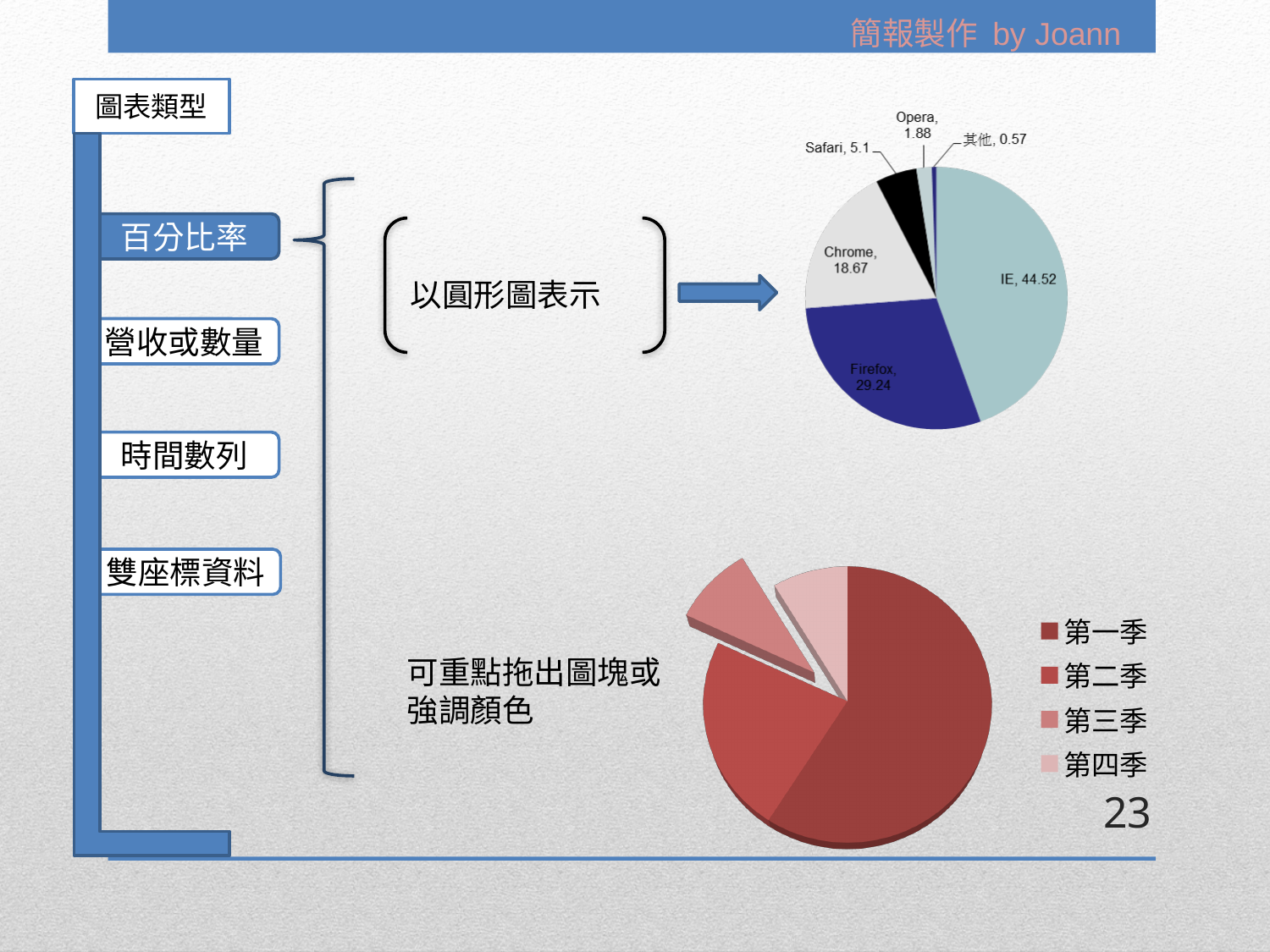
In the pie chart at the top right of the slide, what is the value for Safari? 5.1 In the pie chart at the top right of the slide, which is larger, the value for Chrome or the value for Safari? Chrome How many entries does the legend of the pie chart at the bottom of the slide list? 4 In the pie chart at the top right of the slide, what is the value for Chrome? 18.67 What kind of chart is shown at the bottom of the slide? Pie chart In the pie chart at the top right of the slide, which category has the smallest slice? 其他 In the pie chart at the top right of the slide, what is the value for IE? 44.52 In the pie chart at the top right of the slide, what is the difference between the values for IE and Firefox? 15.28 How many slices does the pie chart at the top right of the slide have? 6 In the pie chart at the top right of the slide, which browser has the largest slice? IE In the pie chart at the top right of the slide, what is the value for Firefox? 29.24 In the pie chart at the top right of the slide, what is the value for 其他? 0.57